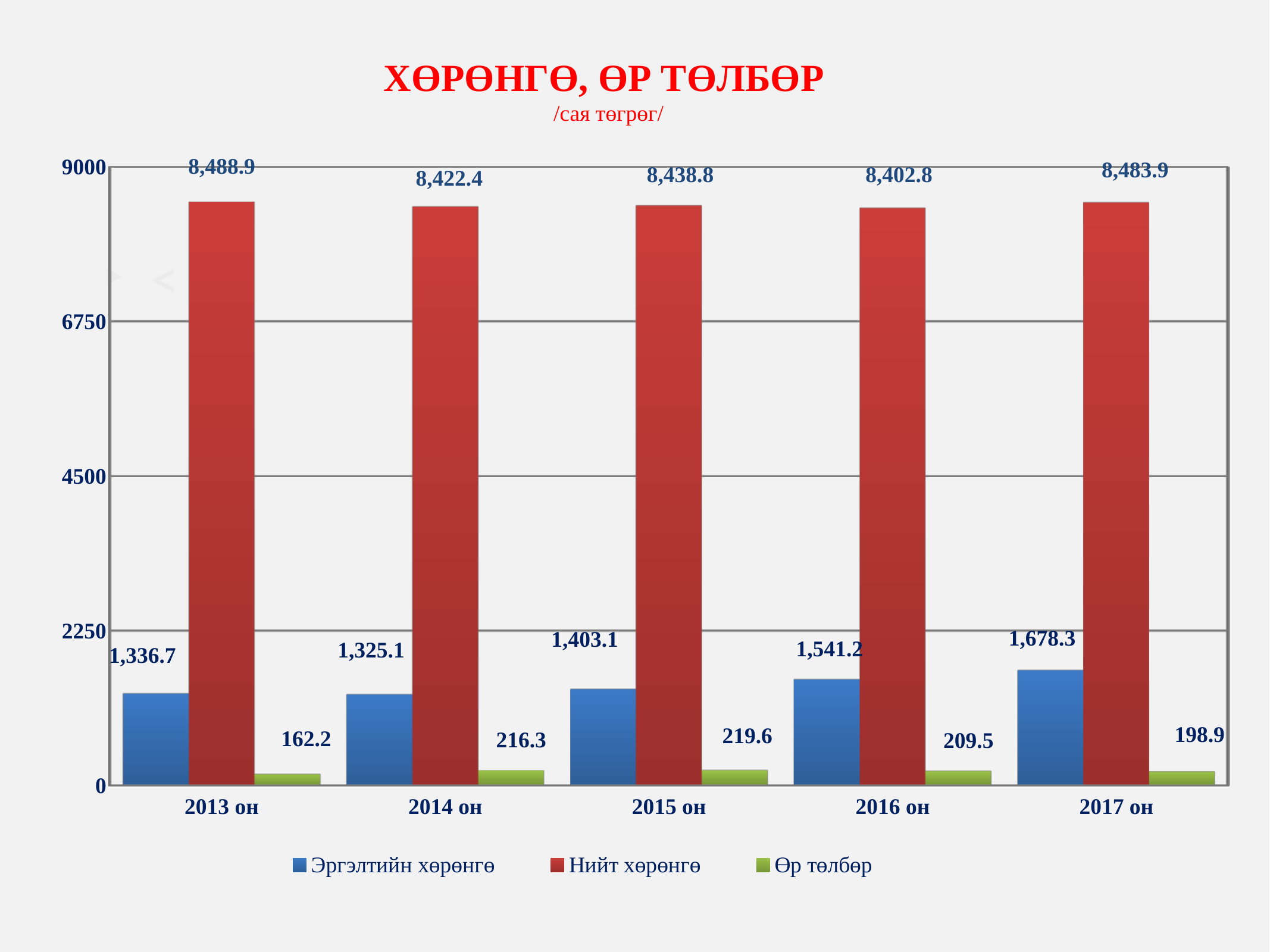
How many years are shown on the x axis? 5 What is the difference between Эргэлтийн хөрөнгө in 2017 он and in 2016 он? 137.1 What is the value of Өр төлбөр for 2015 он? 219.6 What is the value of Нийт хөрөнгө for 2013 он? 8,488.9 Which colour represents Өр төлбөр in the legend? green What is the value of Эргэлтийн хөрөнгө for 2017 он? 1,678.3 Which is larger: Өр төлбөр in 2014 он or in 2016 он? 2014 он Is the value of Нийт хөрөнгө for 2016 он greater or less than 6750? greater In which year is Өр төлбөр lowest? 2013 он In which year is Эргэлтийн хөрөнгө highest? 2017 он What kind of chart is shown on the slide? bar chart How many series does the legend list? 3